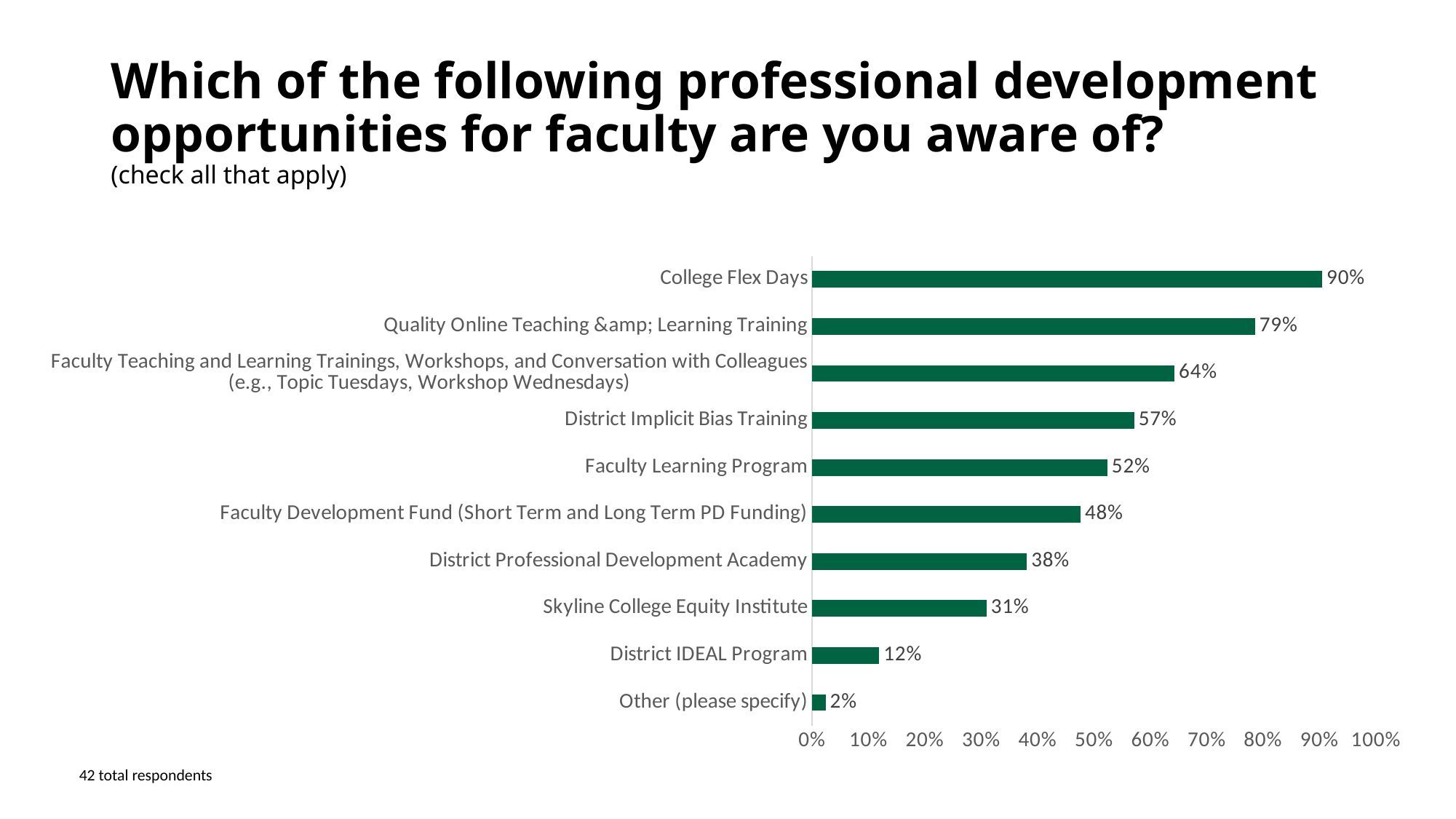
What kind of chart is shown on the slide? Bar chart Which category has the lowest value on the chart? Other (please specify) What percentage of respondents are aware of the District Implicit Bias Training? 57% What is the difference between the Faculty Development Fund value and the District IDEAL Program value? 36 percentage points What percentage of respondents are aware of College Flex Days? 90% What percentage of respondents are aware of the District IDEAL Program? 12% How many categories are shown on the chart? 10 Which has a higher awareness value: Faculty Learning Program or District Professional Development Academy? Faculty Learning Program Which professional development opportunity has the highest awareness? College Flex Days Is the value for Skyline College Equity Institute greater or less than 40%? less What is the difference in percentage points between College Flex Days and Quality Online Teaching & Learning Training? 11 percentage points How many total respondents does the slide note? 42